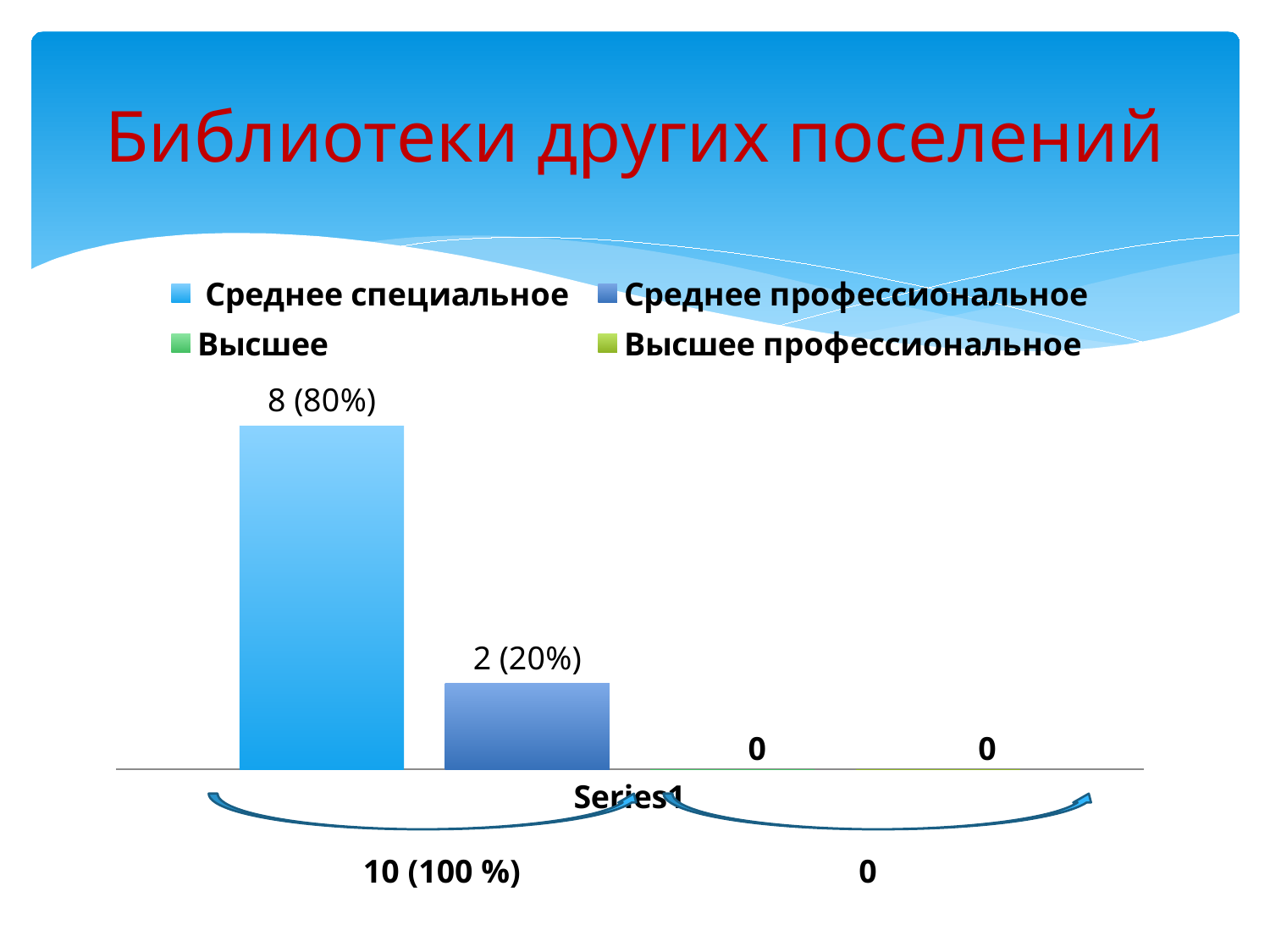
What value is shown for Среднее специальное? 8 (80%) What is the title of the slide? Библиотеки других поселений What value is shown for Среднее профессиональное? 2 (20%) What value is shown for Высшее? 0 What kind of chart is shown on the slide? Bar chart Which series has the highest value? Среднее специальное What total is written under the bracket covering the first two bars? 10 (100 %) What is the category label shown on the x axis? Series1 How many series does the legend list? 4 Which is larger, Среднее специальное or Среднее профессиональное? Среднее специальное What is the difference between the counts for Среднее специальное and Среднее профессиональное? 6 What value is shown for Высшее профессиональное? 0